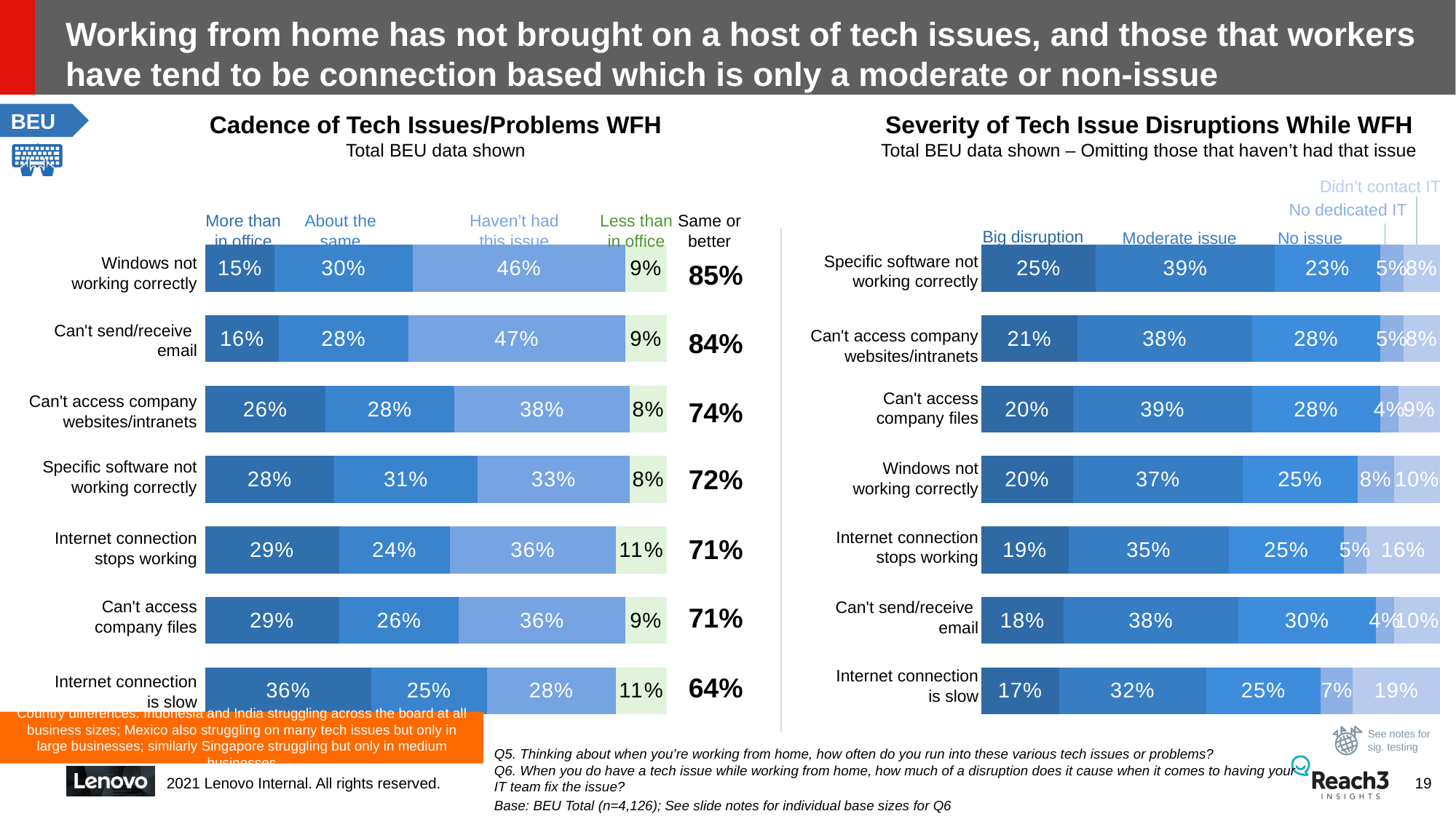
What type of chart is the 'Severity of Tech Issue Disruptions While WFH' chart? Stacked bar chart In the 'Cadence of Tech Issues/Problems WFH' chart, which issue has the highest 'More than in office' value? Internet connection is slow In the 'Cadence of Tech Issues/Problems WFH' chart, which issue has the lowest 'Same or better' value? Internet connection is slow In the 'Severity of Tech Issue Disruptions While WFH' chart, is the 'Moderate issue' value larger for 'Can't access company files' or for 'Internet connection stops working'? Can't access company files In the 'Severity of Tech Issue Disruptions While WFH' chart, which issue has the lowest 'Big disruption' value? Internet connection is slow In the 'Severity of Tech Issue Disruptions While WFH' chart, what is the 'Didn't contact IT' value for 'Internet connection is slow'? 19% How many issue categories are shown in the 'Cadence of Tech Issues/Problems WFH' chart? 7 In the 'Cadence of Tech Issues/Problems WFH' chart, what percentage of respondents said 'Internet connection is slow' happens more than in office? 36% In the 'Severity of Tech Issue Disruptions While WFH' chart, what percentage said 'Specific software not working correctly' was a big disruption? 25% How many series does the legend of the 'Severity of Tech Issue Disruptions While WFH' chart list? 5 In the 'Cadence of Tech Issues/Problems WFH' chart, what is the difference between the 'Haven't had this issue' values for 'Can't send/receive email' and 'Internet connection is slow'? 19% In the 'Cadence of Tech Issues/Problems WFH' chart, what is the 'Same or better' value for 'Windows not working correctly'? 85%